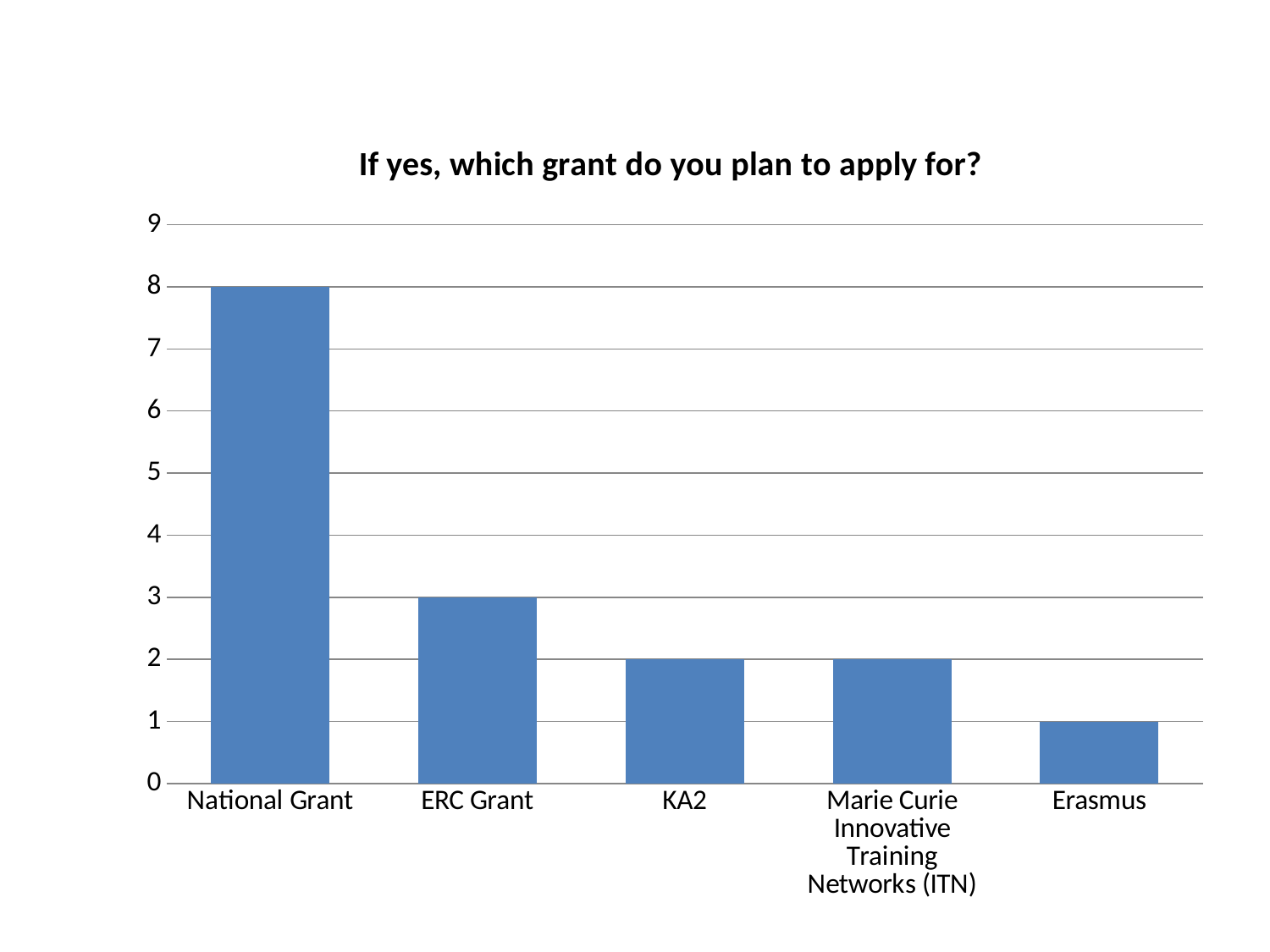
Is the value for National Grant greater or less than 5? greater What is the title of the chart? If yes, which grant do you plan to apply for? Which grant has the lowest value? Erasmus What is the value for National Grant? 8 Which grant has the highest value? National Grant How many grant categories are shown on the chart? 5 What is the value for KA2? 2 What is the difference between the values for National Grant and ERC Grant? 5 What is the value for Erasmus? 1 Which is larger, the value for ERC Grant or the value for Erasmus? ERC Grant What kind of chart is shown on the slide? bar chart What is the value for ERC Grant? 3